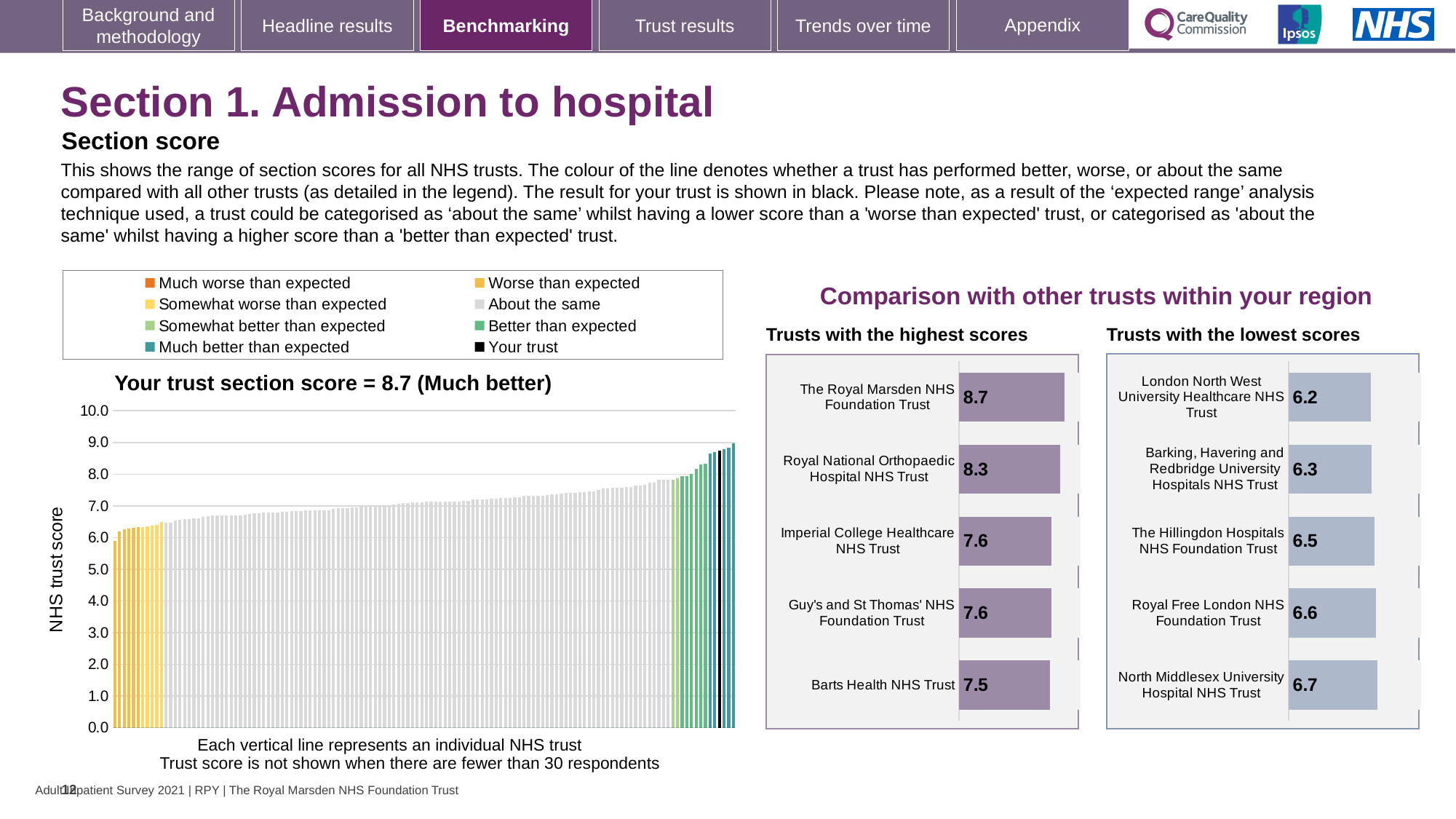
In the 'Trusts with the lowest scores' chart, what is the difference between the scores of North Middlesex University Hospital NHS Trust and London North West University Healthcare NHS Trust? 0.5 In the 'Trusts with the lowest scores' chart, which has the higher score: Royal Free London NHS Foundation Trust or Barking, Havering and Redbridge University Hospitals NHS Trust? Royal Free London NHS Foundation Trust In the 'Your trust section score' chart, do the bars rise or fall from left to right along the x axis? Rise How many trusts are shown in the 'Trusts with the highest scores' chart? 5 In the 'Trusts with the highest scores' chart, what is the score for The Royal Marsden NHS Foundation Trust? 8.7 What type of chart is the 'Your trust section score' chart on the left? Bar chart In the 'Trusts with the highest scores' chart, which trust has the highest score? The Royal Marsden NHS Foundation Trust In the 'Trusts with the lowest scores' chart, what is the score for The Hillingdon Hospitals NHS Foundation Trust? 6.5 In the 'Trusts with the highest scores' chart, what is the difference between the scores of The Royal Marsden NHS Foundation Trust and Royal National Orthopaedic Hospital NHS Trust? 0.4 In the 'Trusts with the lowest scores' chart, which trust has the lowest score? London North West University Healthcare NHS Trust How many entries does the legend above the 'Your trust section score' chart list? 8 In the 'Trusts with the highest scores' chart, what is the score for Barts Health NHS Trust? 7.5